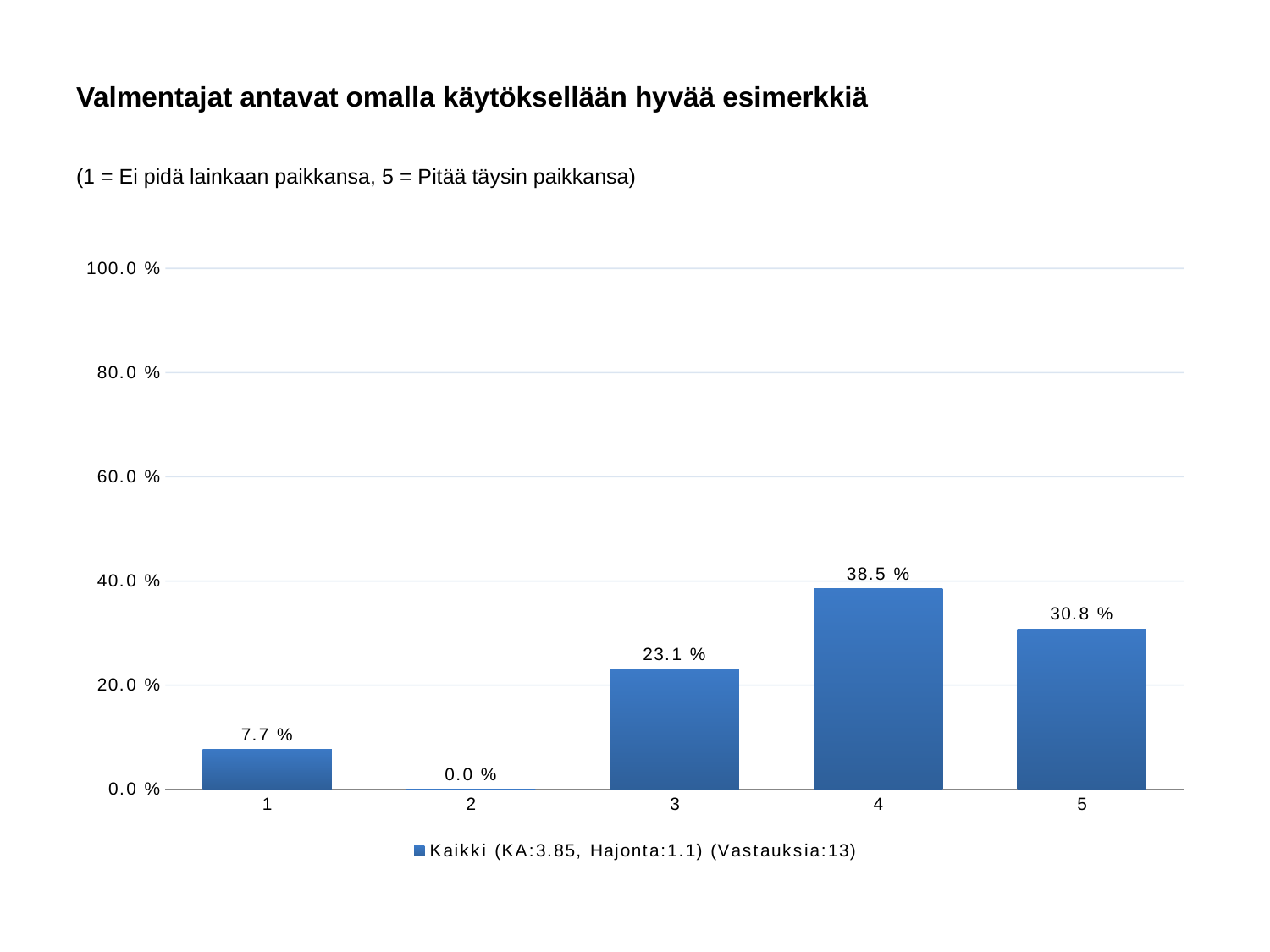
What kind of chart is shown on the slide? bar chart How many categories are shown on the x axis? 5 What is the value for category 4? 38.5 % What is the difference between the values for category 4 and category 5? 7.7 % Which category has the lowest value? 2 Which category has the highest value? 4 Is the value for category 4 greater or less than 40.0 %? less What is the value for category 3? 23.1 % Which is larger, the value for category 3 or the value for category 5? 5 What is the value for category 5? 30.8 % What is the value for category 1? 7.7 % How many responses (Vastauksia) does the legend entry report? 13